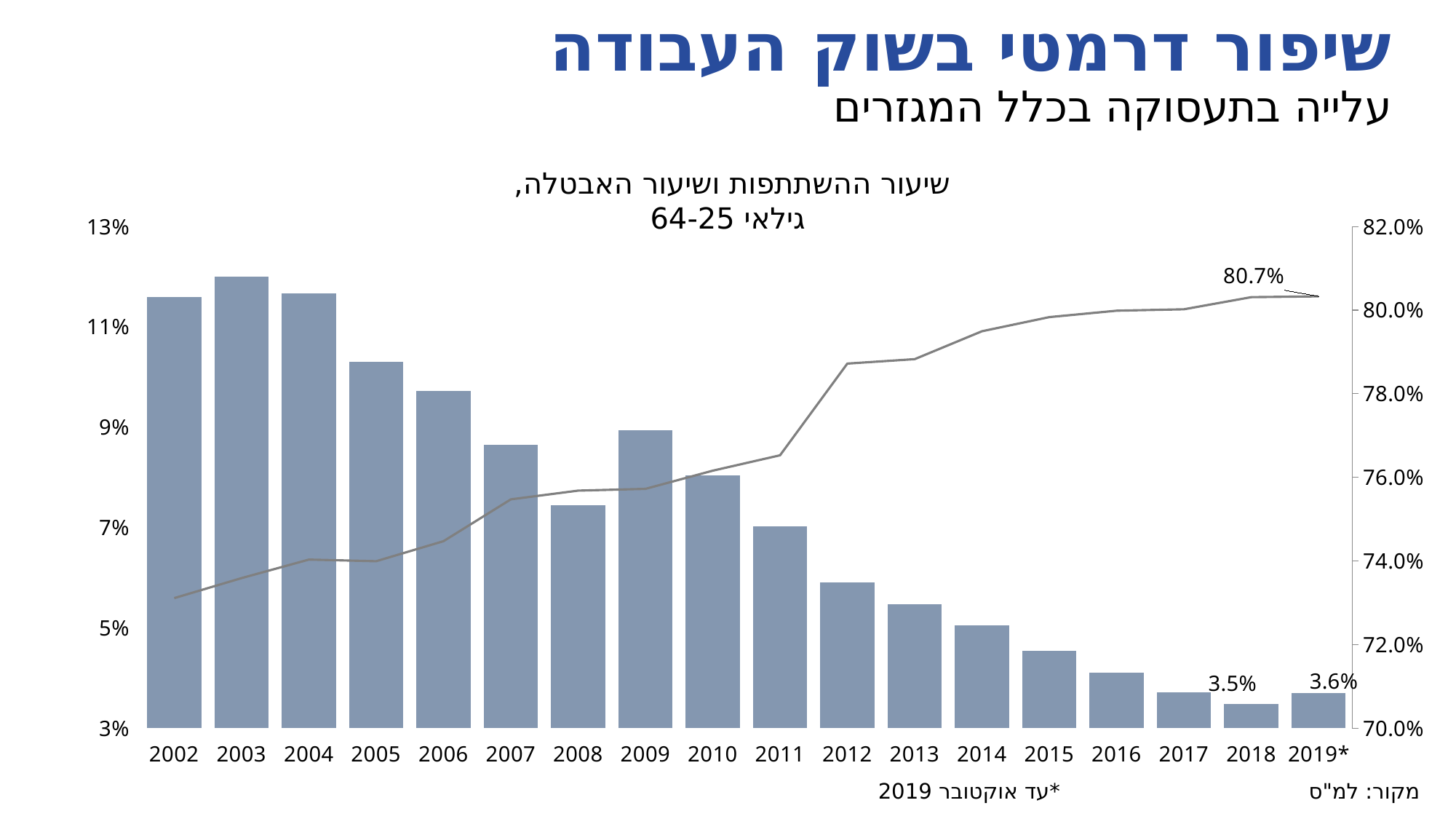
What is the unemployment rate (bar) value shown for 2019*? 3.6% Which bar is taller, 2008 or 2009? 2009 Do the bar values generally rise or fall from 2002 to 2019*? fall What is the source cited at the bottom of the chart? למ"ס How many years are shown on the x axis? 18 What is the difference between the bar values for 2019* and 2018? 0.1% Is the line value for 2012 greater or less than 78.0%? greater Which year has the shortest bar? 2018 Which year has the tallest bar? 2003 What is the unemployment rate (bar) value shown for 2018? 3.5% Is the bar value for 2002 greater or less than 11%? greater What is the participation rate (line) value labelled for 2019*? 80.7%